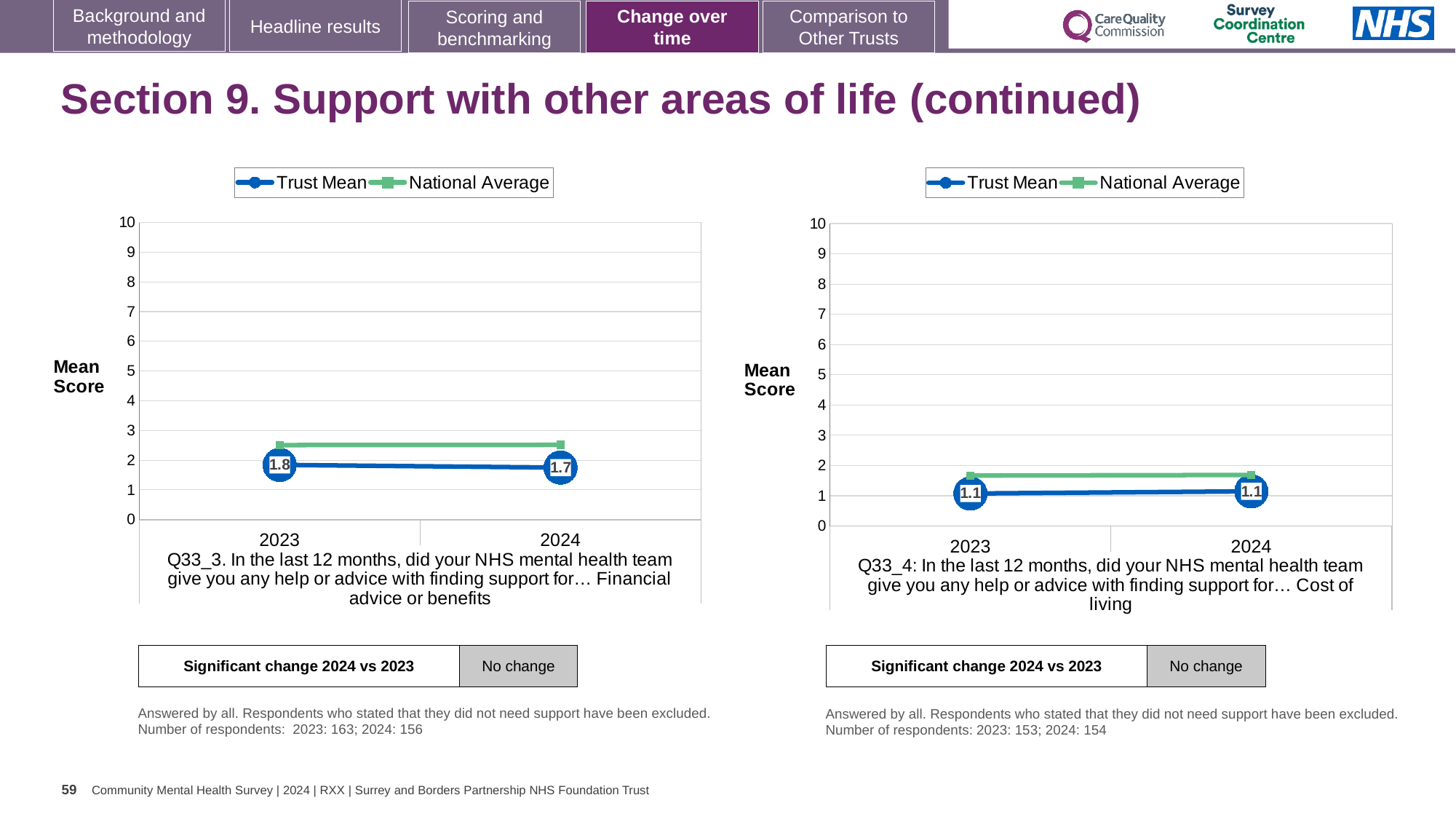
In the right chart (Q33_4), is the National Average value for 2023 greater or less than 2? less In the left chart (Q33_3), which year has the higher Trust Mean score, 2023 or 2024? 2023 In the right chart (Q33_4), which series is higher in 2023, Trust Mean or National Average? National Average How many series does the legend of the left chart list? 2 What kind of chart is the left chart (Q33_3)? Line chart In the left chart (Q33_3), is the National Average value for 2024 greater or less than 2? greater In the left chart (Q33_3, Financial advice or benefits), what is the Trust Mean score for 2023? 1.8 In the left chart (Q33_3), what is the difference between the Trust Mean scores for 2023 and 2024? 0.1 How many years are plotted on the x axis of the right chart (Q33_4)? 2 In the right chart (Q33_4, Cost of living), what is the Trust Mean score for 2024? 1.1 In the left chart (Q33_3, Financial advice or benefits), what is the Trust Mean score for 2024? 1.7 In the right chart (Q33_4), does the Trust Mean rise, fall or stay the same from 2023 to 2024? Stays the same